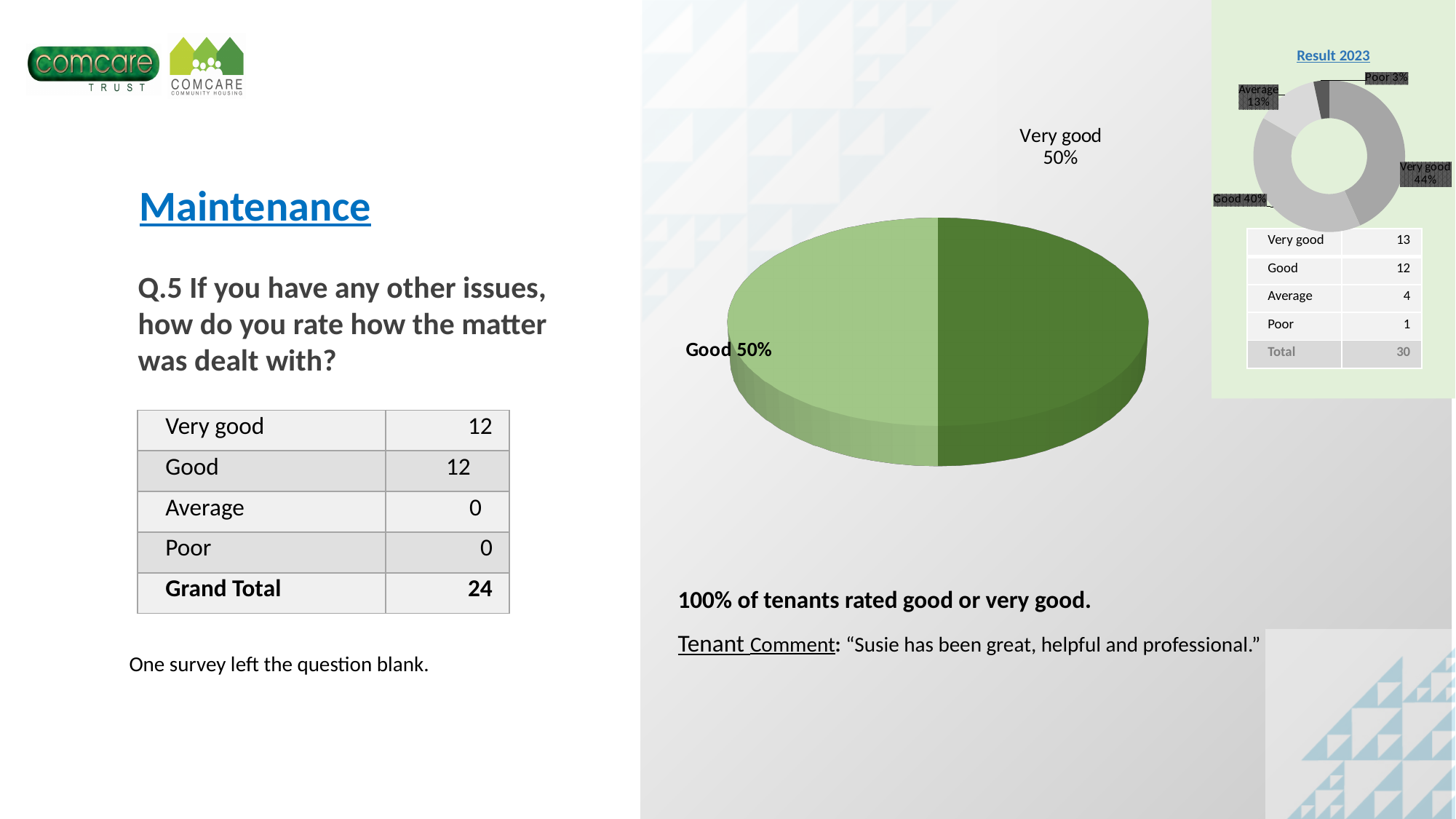
In the Result 2023 donut chart, which category has the smallest share? Poor In the large pie chart, what share is labelled for Good? 50% What kind of chart is the large green chart in the centre of the slide? pie chart In the Result 2023 donut chart, what is the difference in percentage points between the Very good and Average shares? 31 In the Result 2023 donut chart, what share is labelled for Very good? 44% In the Result 2023 donut chart, what share is labelled for Good? 40% How many categories are shown in the Result 2023 donut chart? 4 In the Result 2023 donut chart, which category has the largest share? Very good How many slices does the large pie chart in the centre of the slide have? 2